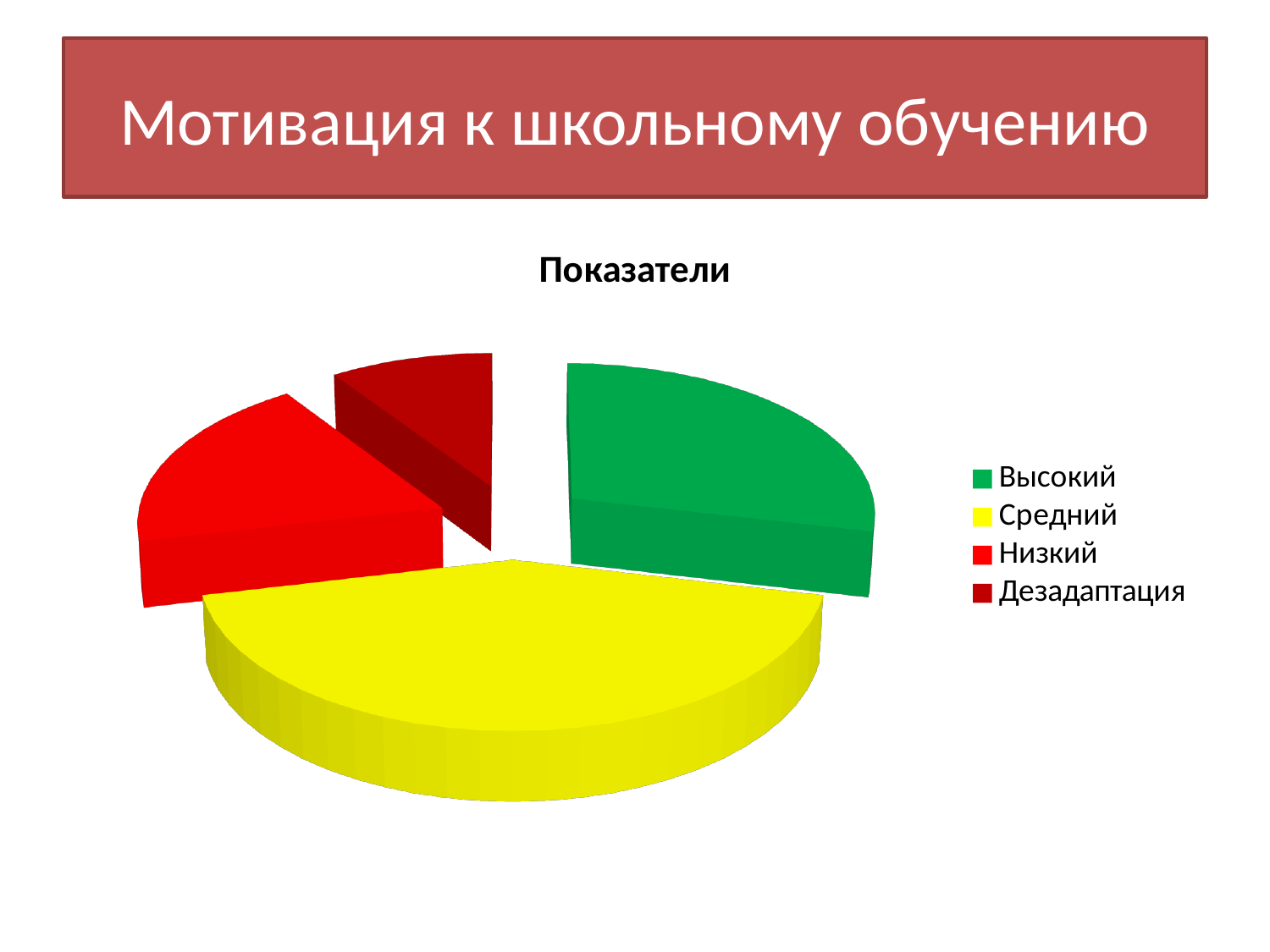
Which slice is larger, Низкий or Дезадаптация? Низкий How many slices does the pie chart have? 4 What kind of chart is shown on the slide? pie chart What colour is the slice for Средний? yellow How many entries does the chart legend list? 4 Which slice is larger, Высокий or Дезадаптация? Высокий Which category has the largest slice of the pie? Средний Which category has the smallest slice of the pie? Дезадаптация What is the title of the chart? Показатели Which slice is larger, Средний or Высокий? Средний